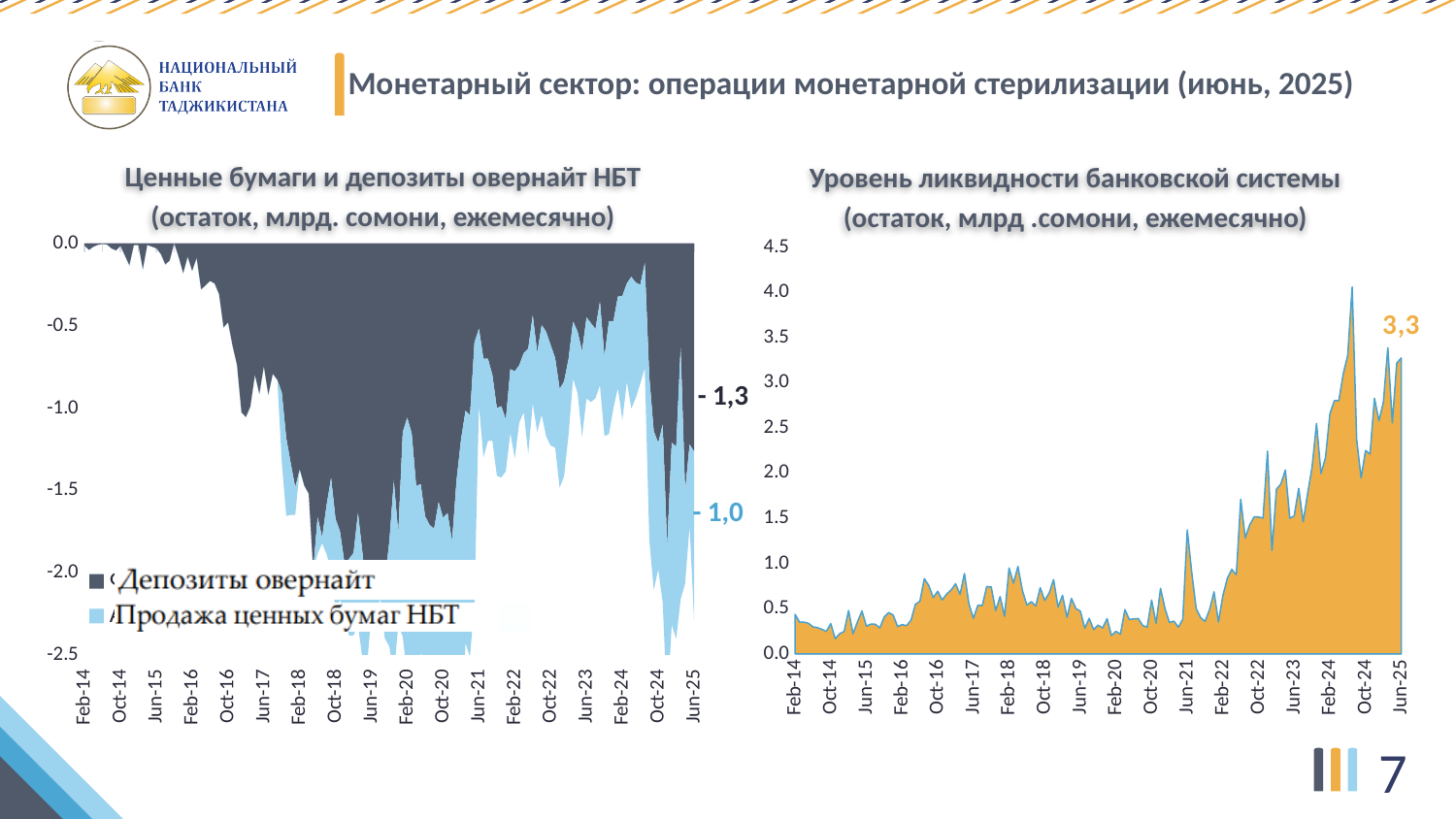
In the chart 'Уровень ликвидности банковской системы', is the highest peak of the series greater or less than 3.5? greater What are the legend entries in the chart 'Ценные бумаги и депозиты овернайт НБТ'? Депозиты овернайт; Продажа ценных бумаг НБТ In the chart 'Ценные бумаги и депозиты овернайт НБТ', what is the difference between the labelled end values -1,3 and -1,0? 0,3 In the chart 'Уровень ликвидности банковской системы', what value is labelled at the end of the series (Jun-25)? 3,3 What kind of chart is 'Уровень ликвидности банковской системы'? Area chart In the chart 'Ценные бумаги и депозиты овернайт НБТ', what value is labelled for 'Депозиты овернайт' at the end of the series? -1,3 In the chart 'Ценные бумаги и депозиты овернайт НБТ', what value is labelled for 'Продажа ценных бумаг НБТ' at the end of the series? -1,0 How many series does the legend of the chart 'Ценные бумаги и депозиты овернайт НБТ' list? 2 In the chart 'Уровень ликвидности банковской системы', is the value at Feb-14 greater or less than 0.5? less In the chart 'Уровень ликвидности банковской системы', do the values overall rise or fall from Feb-14 to Jun-25? Rise In the chart 'Уровень ликвидности банковской системы', is the value at Jun-25 greater or less than 3.0? greater In the chart 'Ценные бумаги и депозиты овернайт НБТ', which series has the larger absolute labelled value at the end: 'Депозиты овернайт' or 'Продажа ценных бумаг НБТ'? Депозиты овернайт